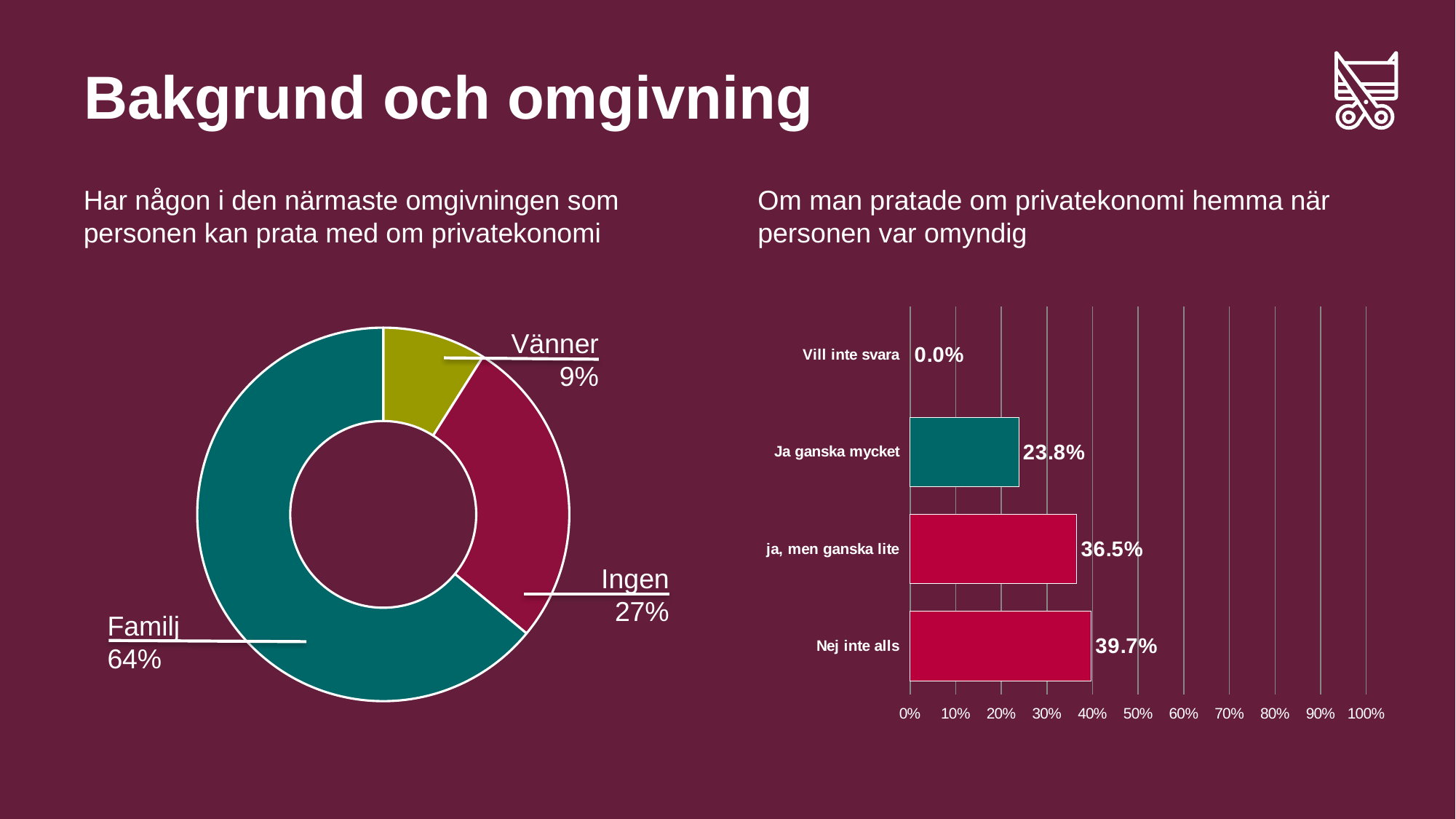
In the right chart (Om man pratade om privatekonomi hemma när personen var omyndig), what is the value for Nej inte alls? 39.7% In the left chart, which category has the largest share? Familj In the left chart (Har någon i den närmaste omgivningen som personen kan prata med om privatekonomi), what share is Familj? 64% In the right chart, which category has the lowest value? Vill inte svara In the left chart, what share is Ingen? 27% In the left chart, what share is Vänner? 9% In the left chart, how many categories are shown? 3 In the left chart, which category has the smallest share? Vänner What kind of chart is the left chart? Pie (donut) chart In the right chart, what is the difference between Nej inte alls and ja, men ganska lite? 3.2% What kind of chart is the right chart? Bar chart In the right chart, what is the value for Ja ganska mycket? 23.8%